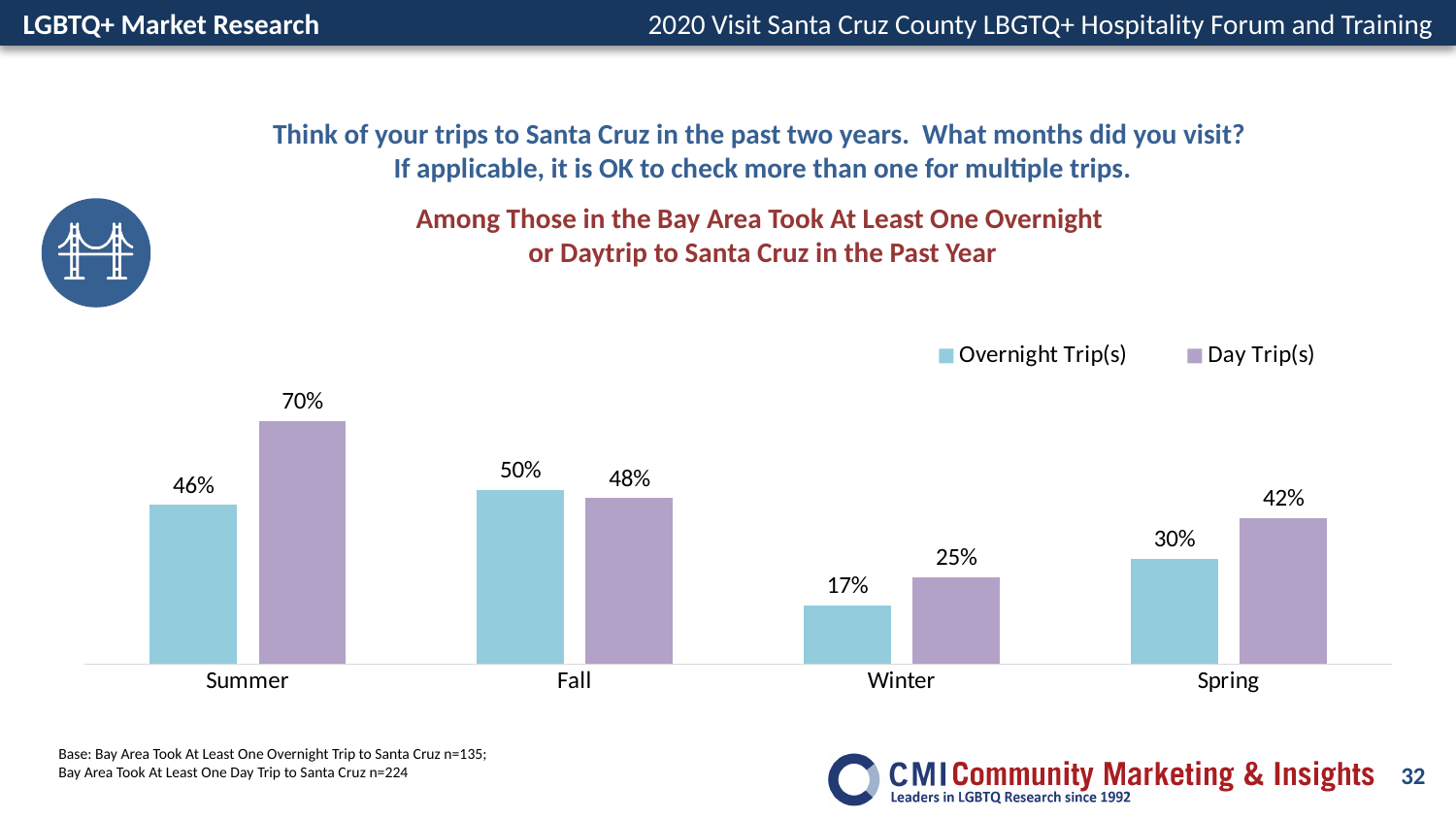
What percentage of Overnight Trip(s) respondents visited Santa Cruz in Summer? 46% What is the difference between the Day Trip(s) values for Spring and Winter? 17% How many seasons are shown on the x axis? 4 What kind of chart is shown on the slide? Bar chart Which season has the highest Day Trip(s) value? Summer Which season has the lowest Overnight Trip(s) value? Winter What is the difference between the Day Trip(s) and Overnight Trip(s) values for Summer? 24% Which series is shown in purple in the legend? Day Trip(s) How many series does the legend list? 2 What is the Day Trip(s) value for Winter? 25% Which is larger for Fall: the Overnight Trip(s) value or the Day Trip(s) value? Overnight Trip(s) What is the Overnight Trip(s) value for Spring? 30%